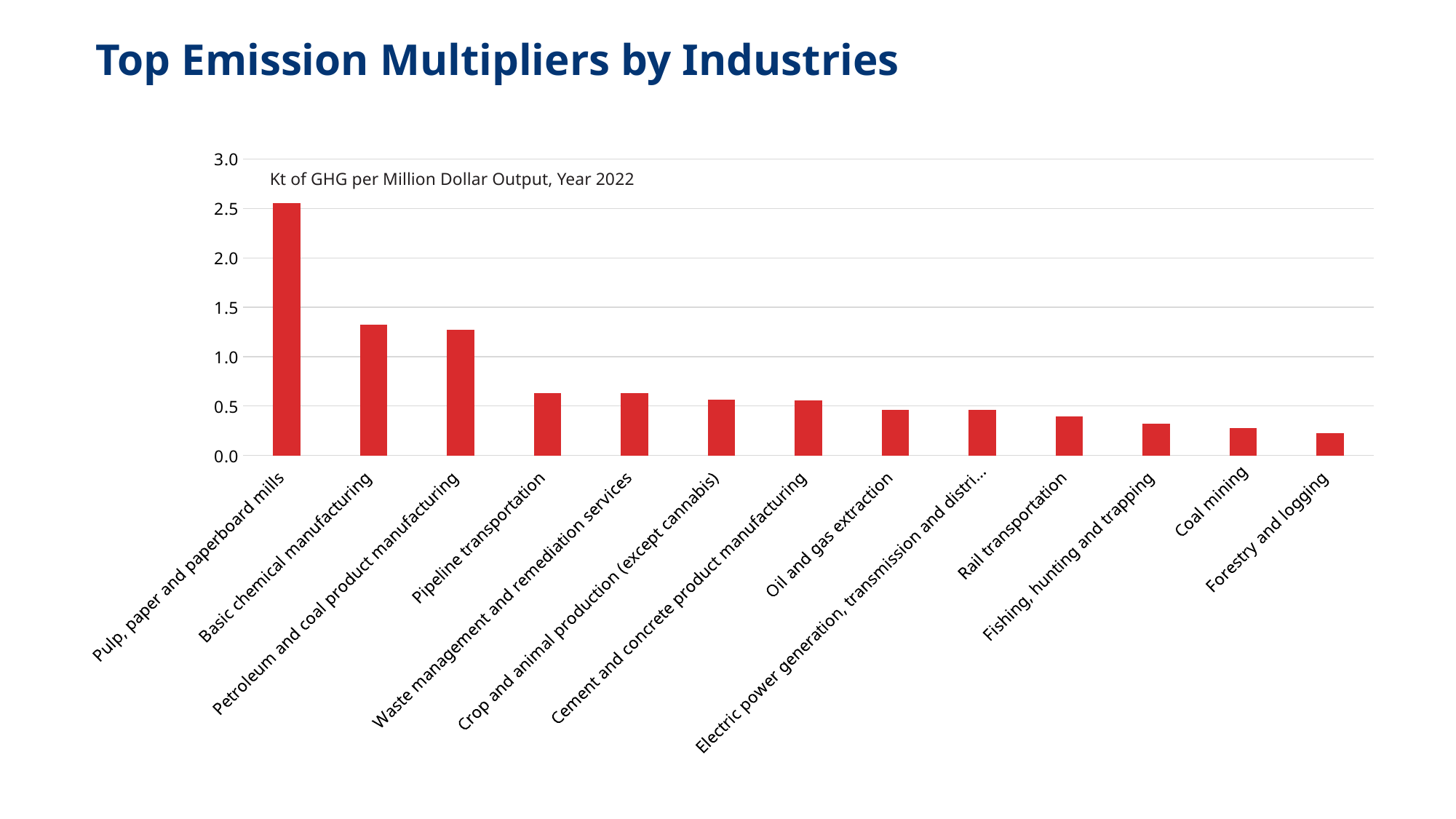
Which is larger, the value for Pulp, paper and paperboard mills or the value for Basic chemical manufacturing? Pulp, paper and paperboard mills Which industry has the lowest emission multiplier? Forestry and logging Is the value for Basic chemical manufacturing greater or less than 1.0? greater Do the values rise or fall moving from left to right along the x axis? Fall Which industry has the highest emission multiplier? Pulp, paper and paperboard mills Is the value for Pulp, paper and paperboard mills greater or less than 2.0? greater How many industries are plotted in the chart? 13 What unit and year does the chart's subtitle state the values are in? Kt of GHG per Million Dollar Output, Year 2022 Is the value for Rail transportation greater or less than 0.5? less What kind of chart is shown on the slide? Bar chart